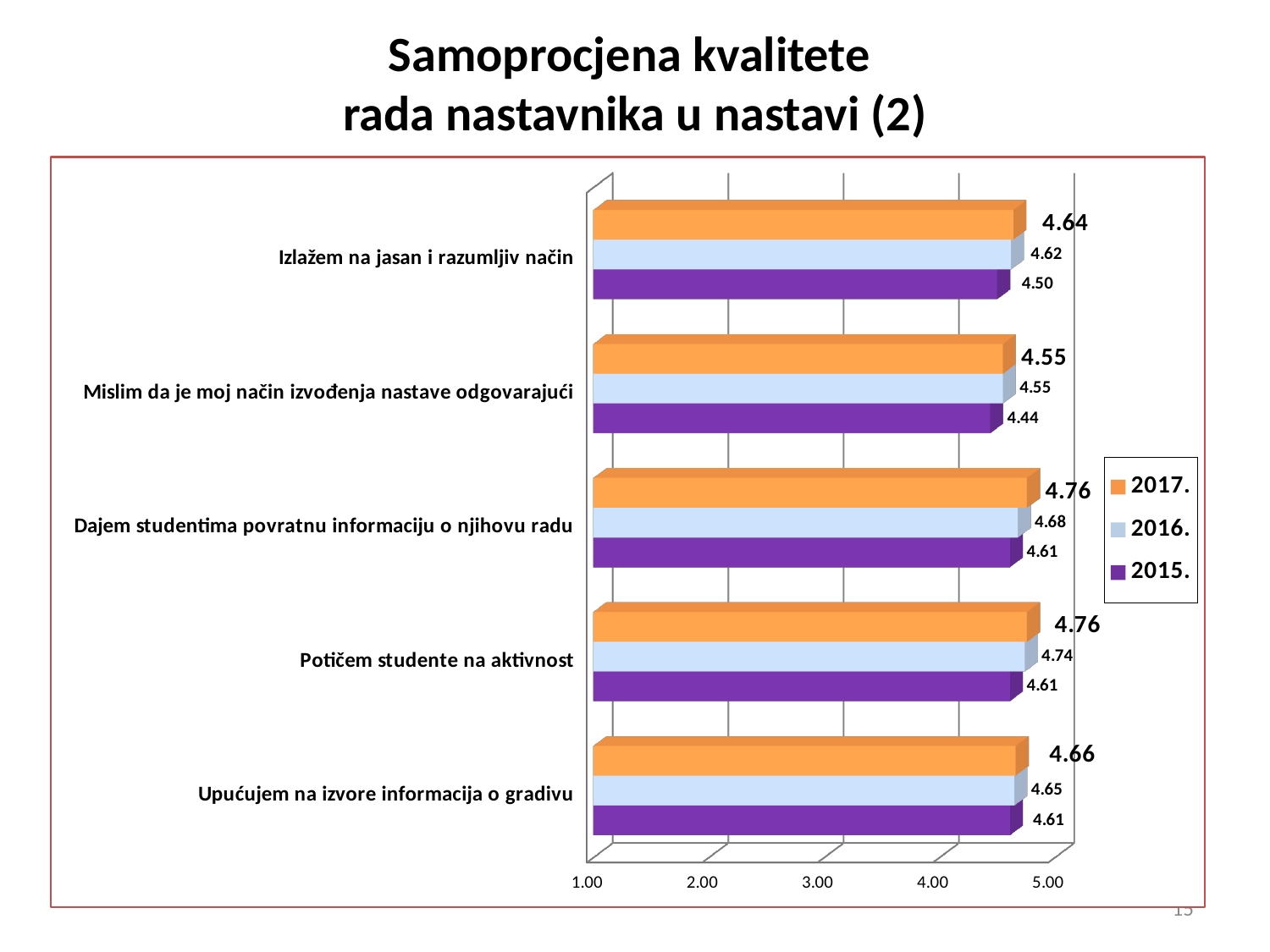
What is the 2017. value for "Izlažem na jasan i razumljiv način"? 4.64 What is the 2015. value for "Mislim da je moj način izvođenja nastave odgovarajući"? 4.44 What is the 2016. value for "Potičem studente na aktivnost"? 4.74 How many categories are shown on the chart? 5 Which colour represents the 2015. series in the legend? purple What is the difference between the 2017. and 2015. values for "Izlažem na jasan i razumljiv način"? 0.14 Is the 2015. value for "Upućujem na izvore informacija o gradivu" greater or less than 4.00? greater What kind of chart is shown on the slide? bar chart How many series does the legend list? 3 Which category has the lowest 2015. value? Mislim da je moj način izvođenja nastave odgovarajući Which is larger for "Dajem studentima povratnu informaciju o njihovu radu": the 2017. value or the 2015. value? 2017. Which category has the highest 2016. value? Potičem studente na aktivnost